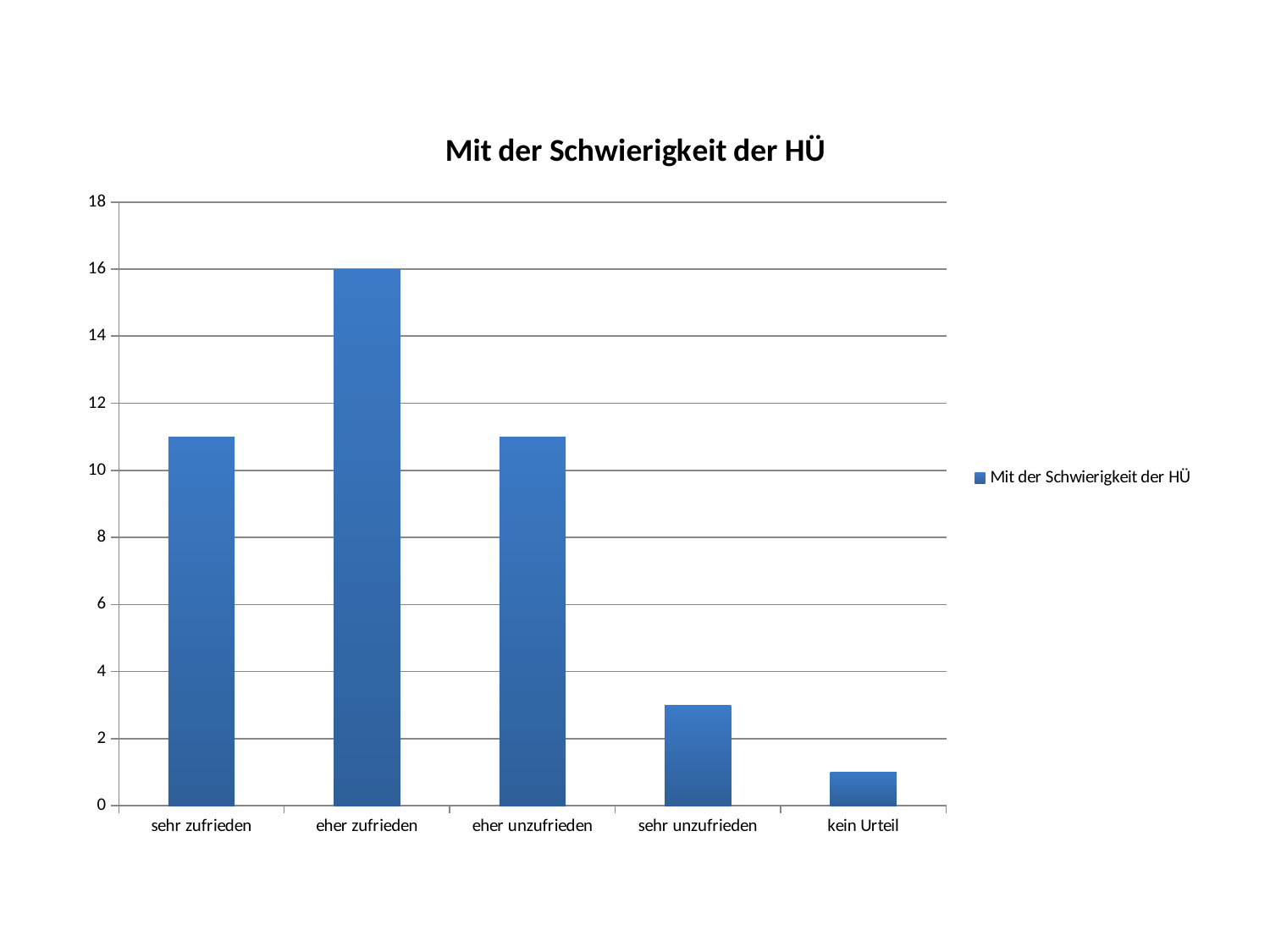
What is the value for "eher zufrieden"? 16 Is the value for "sehr zufrieden" greater or less than 10? greater Is the value for "kein Urteil" greater or less than 2? less How many categories are shown on the x axis? 5 What type of chart is shown? bar chart Is the value for "eher unzufrieden" greater or less than 12? less How many series does the legend list? 1 Which category has the highest value? eher zufrieden Which is larger, the value for "eher zufrieden" or the value for "sehr zufrieden"? eher zufrieden Which is larger, the value for "sehr unzufrieden" or the value for "kein Urteil"? sehr unzufrieden Which category has the lowest value? kein Urteil